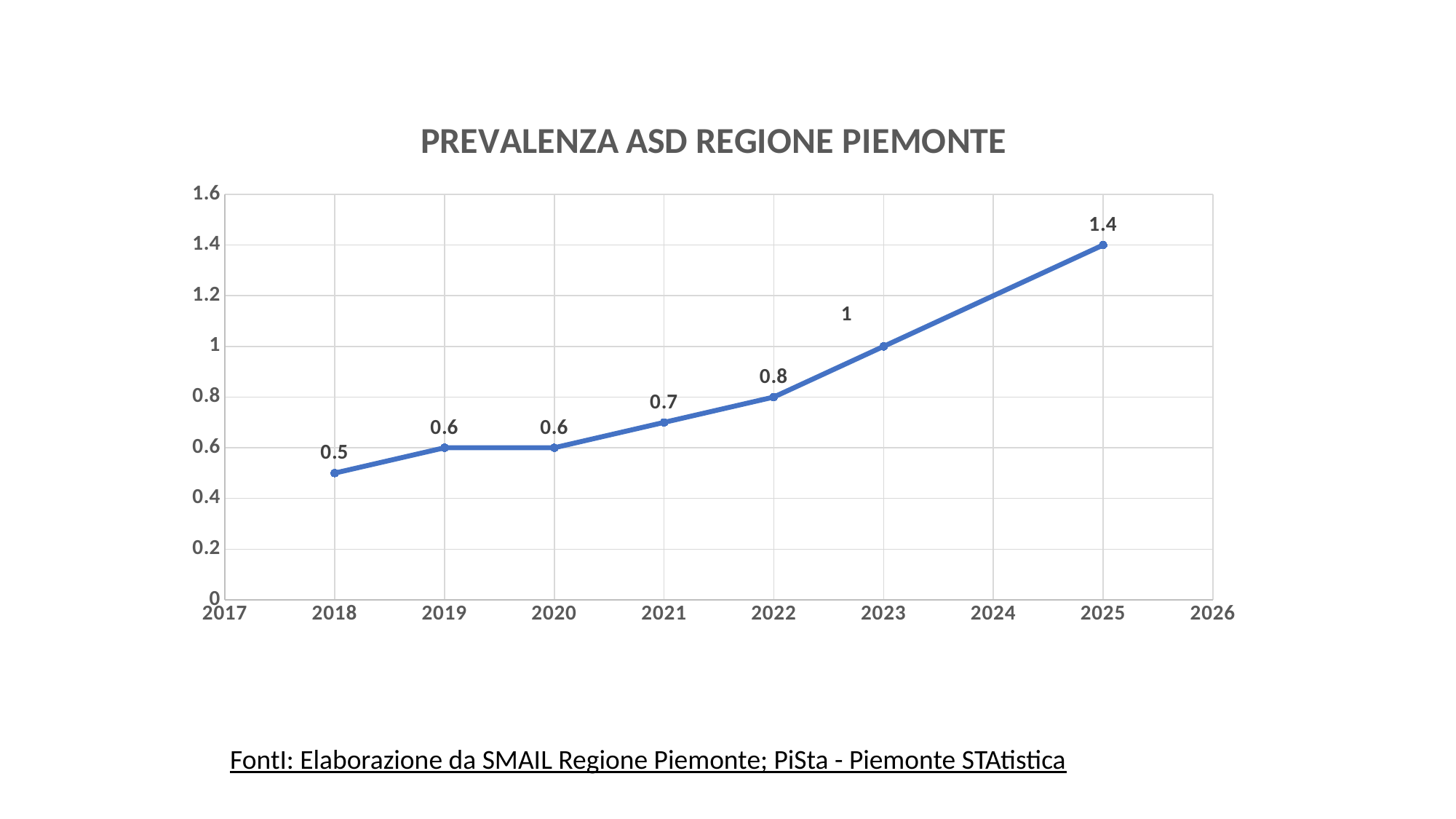
What kind of chart is shown? line chart Which year has the lowest value? 2018 Do the values rise or fall from 2018 to 2025? rise What is the value for 2023? 1 Which is larger, the value for 2022 or the value for 2021? 2022 What is the value for 2025? 1.4 What is the value for 2021? 0.7 What is the title of the chart? PREVALENZA ASD REGIONE PIEMONTE What is the difference between the values for 2025 and 2023? 0.4 What is the value for 2018? 0.5 How many data points are plotted on the line? 7 Which year has the highest value? 2025